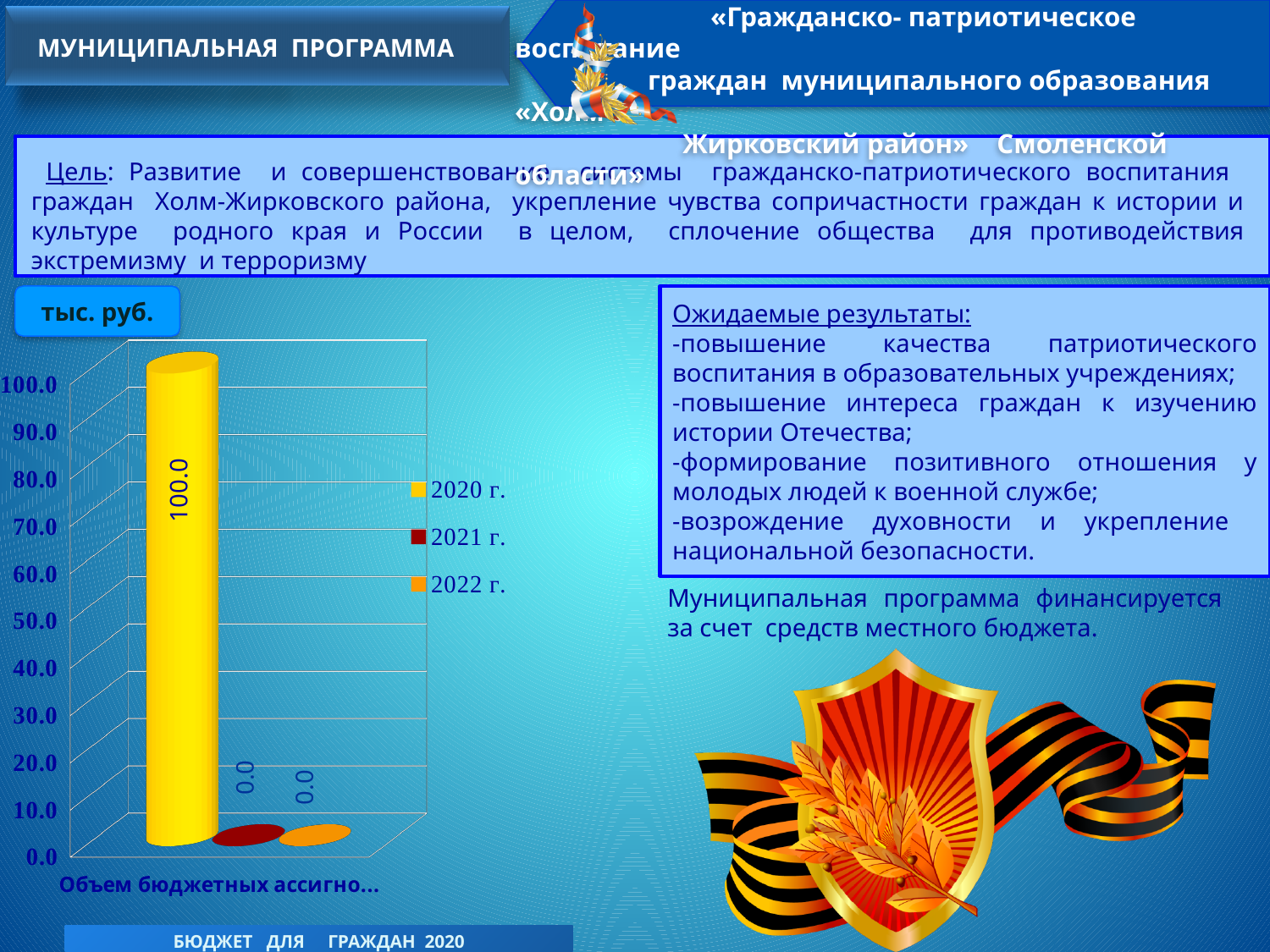
What is the value for 2022 г. in the chart? 0.0 What is the value for 2020 г. in the chart? 100.0 Which year has the highest value in the chart? 2020 г. Which is larger, the value for 2020 г. or the value for 2022 г.? 2020 г. Is the value for 2020 г. greater or less than 50.0? greater What is the value for 2021 г. in the chart? 0.0 What unit is indicated for the chart values in the label above the chart? тыс. руб. What is the highest tick value shown on the vertical axis of the chart? 100.0 How many series does the chart legend list? 3 What kind of chart is shown on the slide? bar chart What is the total of the values for 2020 г., 2021 г. and 2022 г.? 100.0 What is the difference between the values for 2020 г. and 2021 г.? 100.0